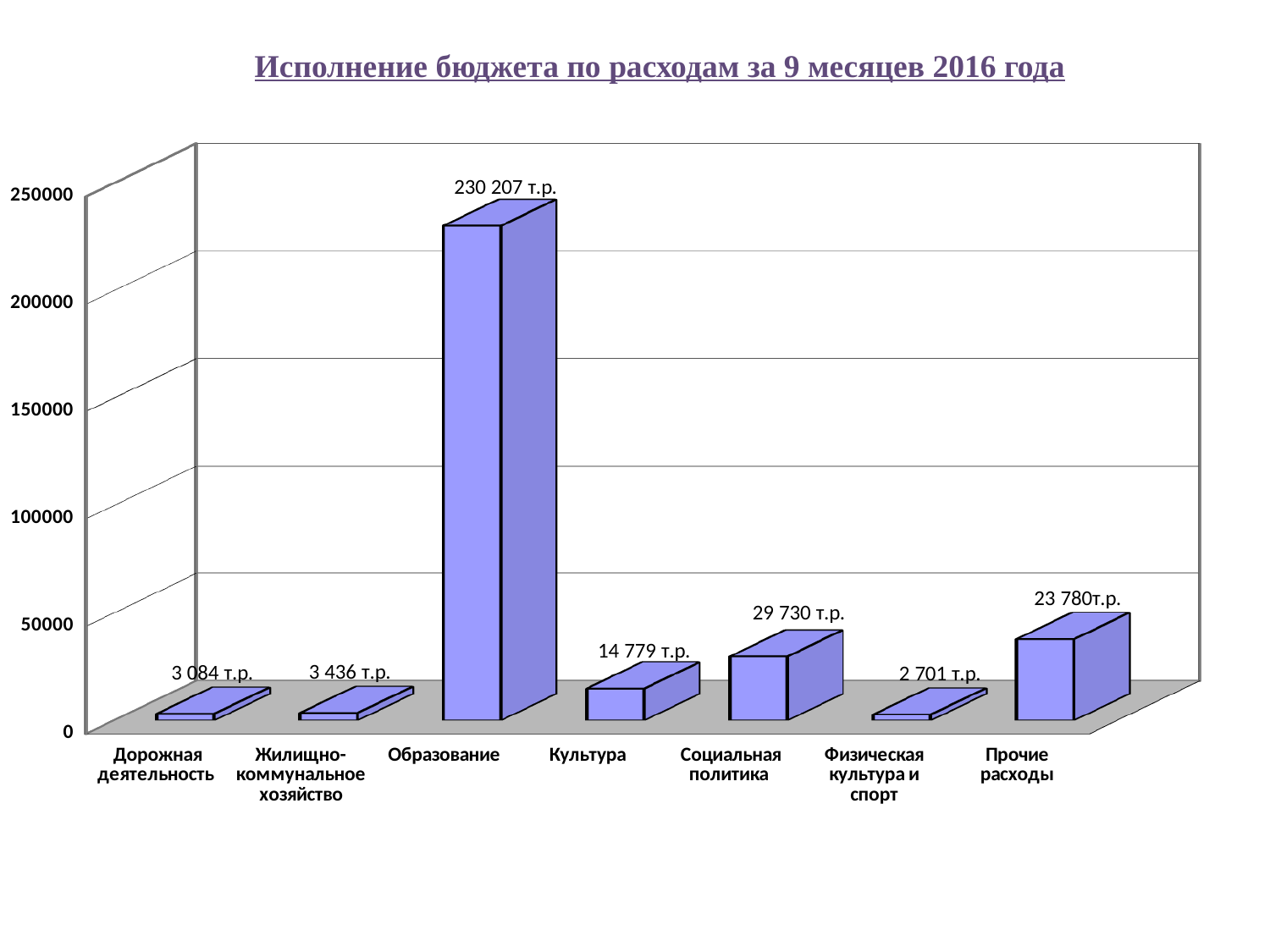
What is the value for Социальная политика? 29 730 т.р. What is the value for Прочие расходы? 23 780т.р. Is the value for Культура greater or less than 50000? less What is the title of the slide? Исполнение бюджета по расходам за 9 месяцев 2016 года What kind of chart is shown on the slide? bar chart Which category has the lowest value? Физическая культура и спорт What is the value for Физическая культура и спорт? 2 701 т.р. What is the difference between Социальная политика and Прочие расходы? 5 950 т.р. Which category has the highest value? Образование Which is larger, Дорожная деятельность or Жилищно-коммунальное хозяйство? Жилищно-коммунальное хозяйство How many categories are shown on the chart? 7 What is the value for Образование? 230 207 т.р.